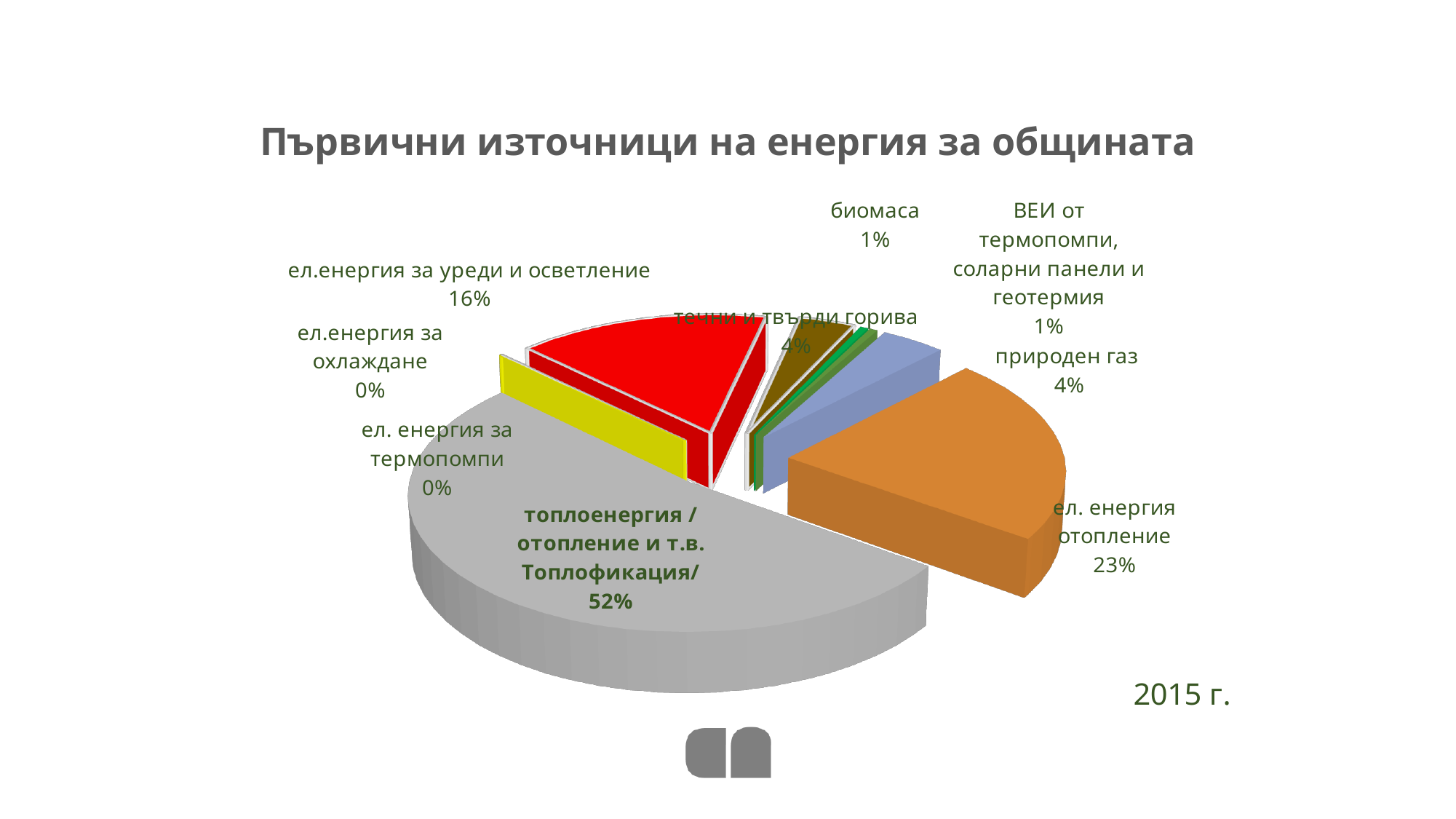
Which year is indicated on the slide for the chart data? 2015 г. Which category has the largest share of the pie? топлоенергия / отопление и т.в. Топлофикация/ What share of the pie does "топлоенергия / отопление и т.в. Топлофикация/" have? 52% What is the value shown for "ел.енергия за уреди и осветление"? 16% What share of the pie does "ел. енергия отопление" have? 23% Which is larger, the share for "ел. енергия отопление" or the share for "природен газ"? ел. енергия отопление How many categories are labelled on the pie chart? 9 What is the value shown for "биомаса"? 1% What is the title of the chart? Първични източници на енергия за общината What kind of chart is shown on the slide? pie chart What is the difference between the shares of "ел. енергия отопление" and "ел.енергия за уреди и осветление"? 7% What is the value shown for "природен газ"? 4%